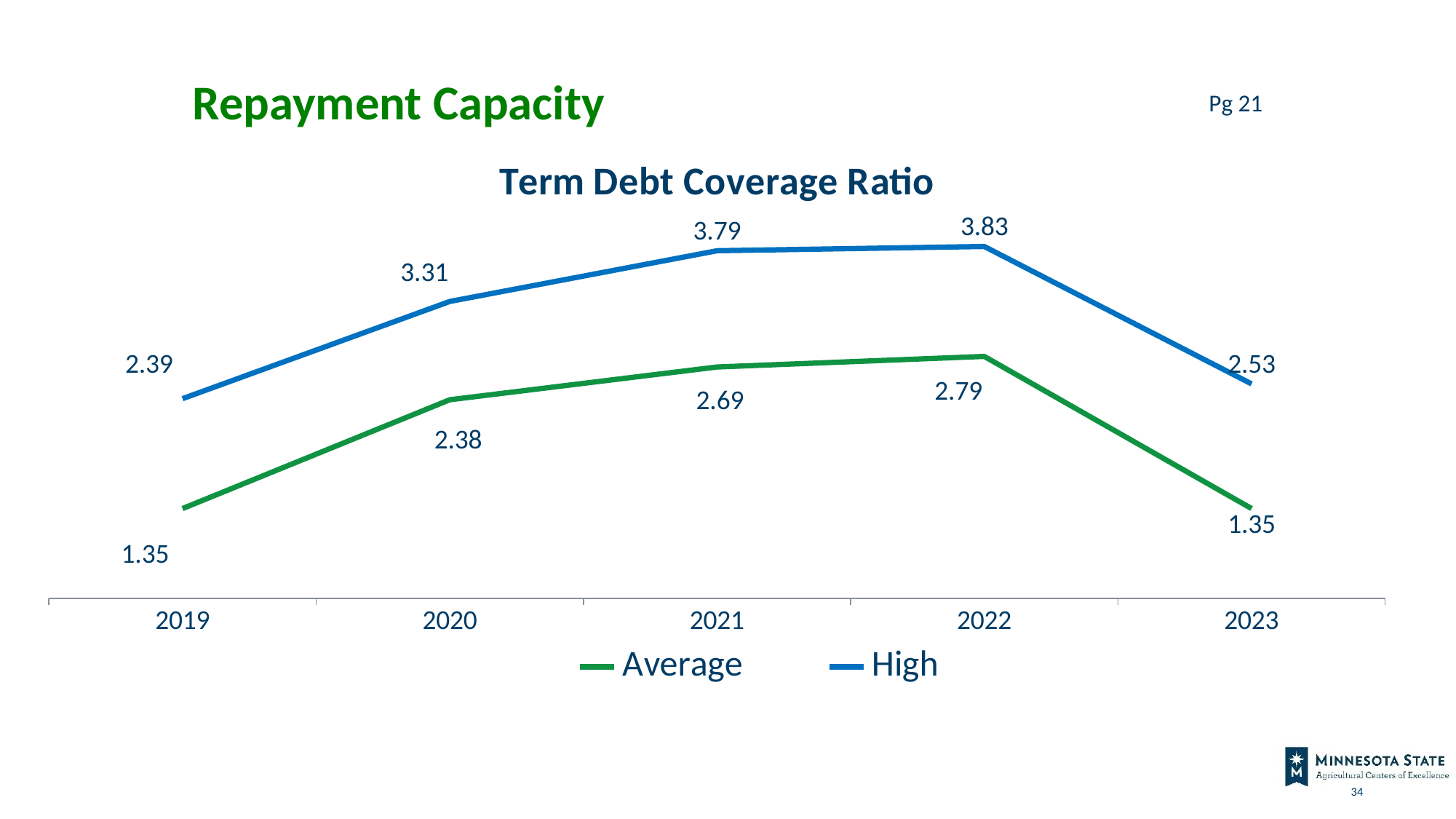
What is the Average value for 2020? 2.38 What is the Average value for 2023? 1.35 How many years are shown on the x axis? 5 What is the difference between the High and Average values in 2021? 1.10 Which is larger, the Average value in 2020 or the Average value in 2022? 2022 How many series does the legend list? 2 What is the High value for 2019? 2.39 In which year is the High series at its highest? 2022 What kind of chart is this? Line chart What is the difference between the High values in 2023 and 2019? 0.14 In which year is the Average series at its highest? 2022 What is the High value for 2022? 3.83